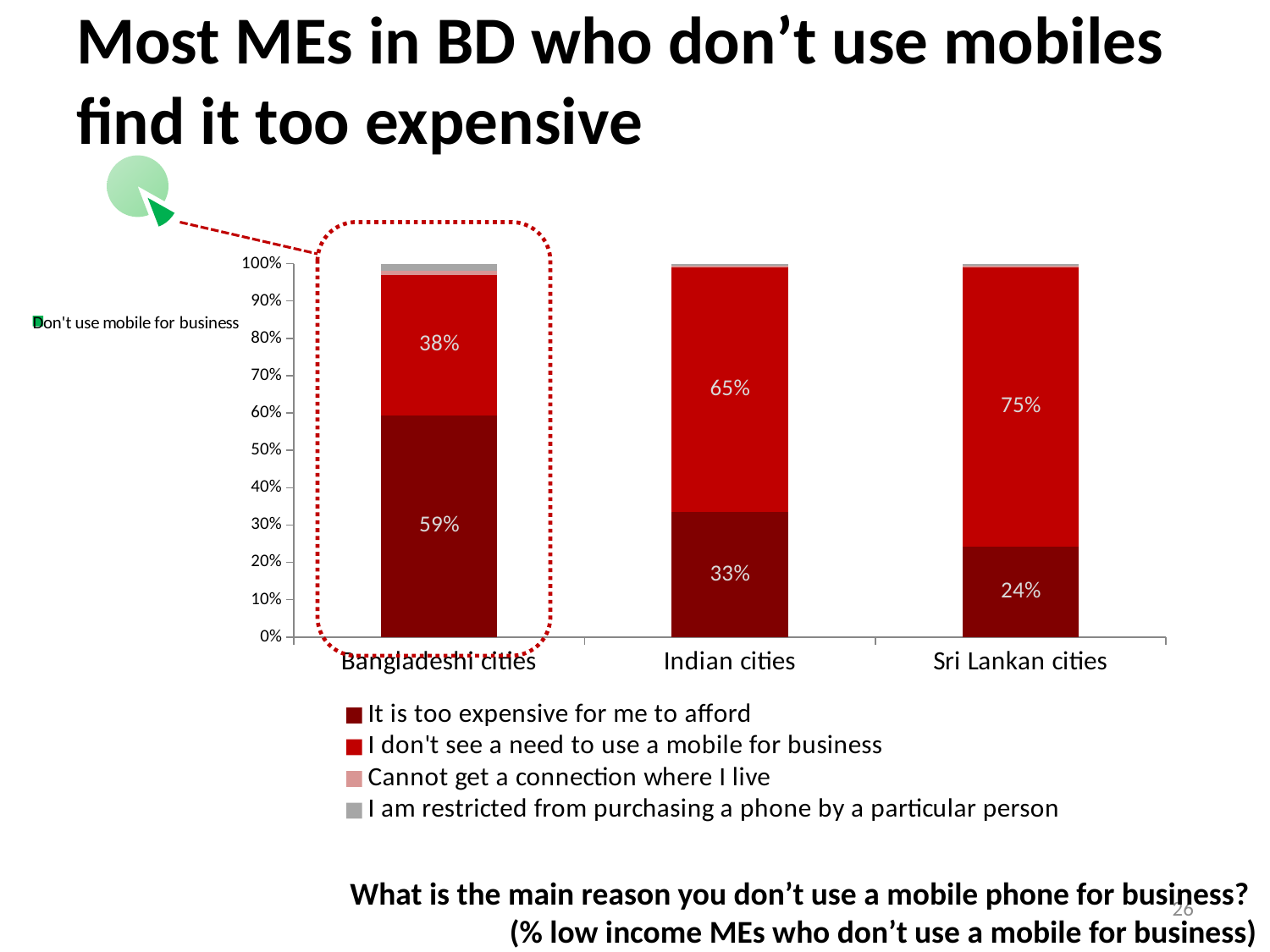
Which city group has the lowest share saying it is too expensive for them to afford? Sri Lankan cities What percentage of low income MEs in Sri Lankan cities say it is too expensive for them to afford? 24% Which city group has the highest share saying it is too expensive for them to afford? Bangladeshi cities How many city groups are shown on the x axis? 3 Does the 'too expensive' share rise or fall moving from Bangladeshi cities to Sri Lankan cities? Fall What is the difference between the 'too expensive' share in Bangladeshi cities and in Indian cities? 26% What percentage of low income MEs in Bangladeshi cities say it is too expensive for them to afford? 59% Which is larger in Indian cities: the share saying it is too expensive or the share saying they don't see a need? I don't see a need to use a mobile for business How many series does the legend list? 4 What percentage of low income MEs in Sri Lankan cities say they don't see a need to use a mobile for business? 75% What kind of chart is shown on the slide? Stacked bar chart What percentage of low income MEs in Indian cities say they don't see a need to use a mobile for business? 65%